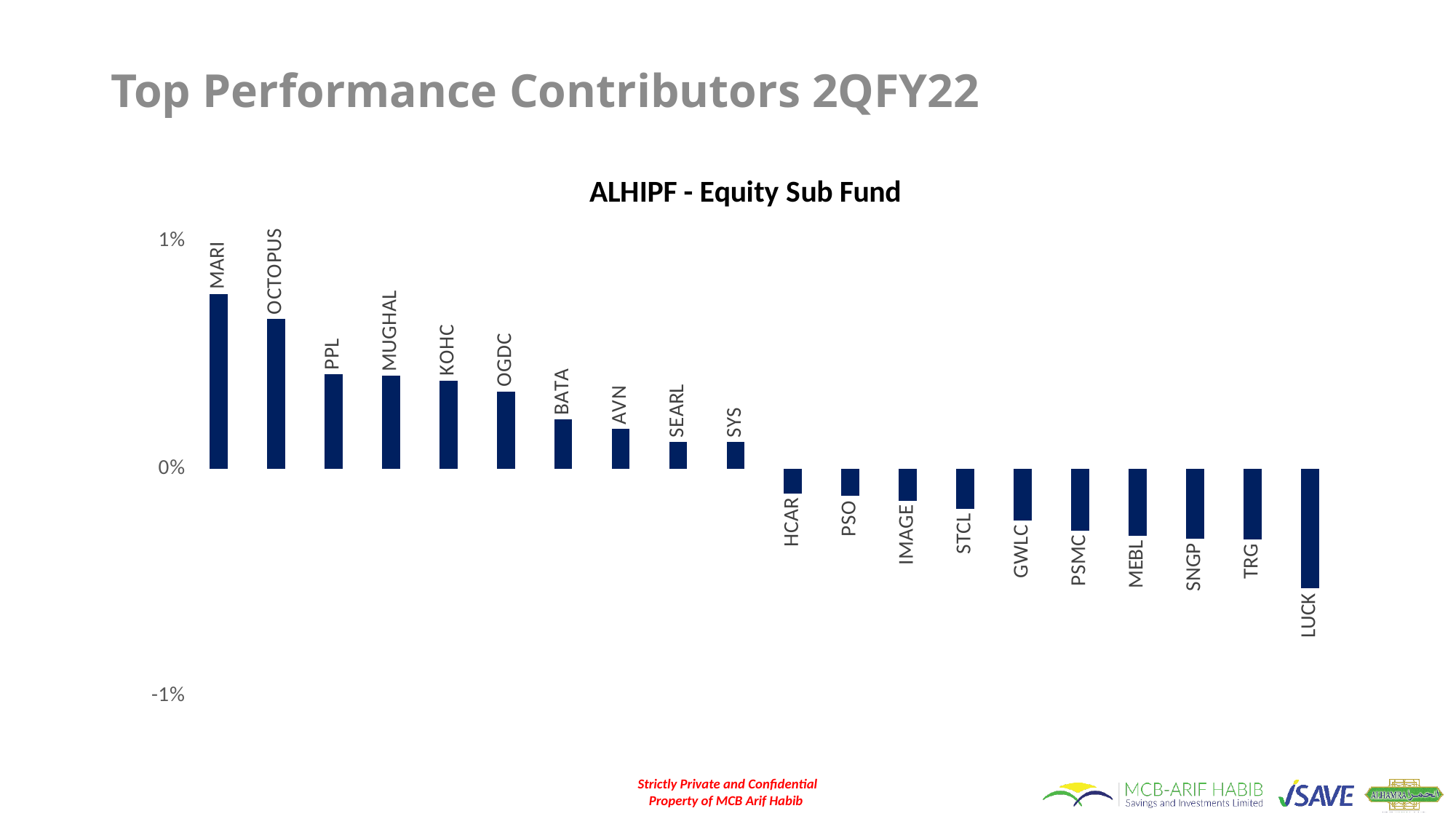
Which is larger, the value for MARI or the value for OCTOPUS? MARI Is the value for OCTOPUS greater or less than 1%? less Which category has the highest value in the chart? MARI What is the title of the chart? ALHIPF - Equity Sub Fund Which is larger, the value for SYS or the value for LUCK? SYS Which category has the lowest value in the chart? LUCK Is the value for HCAR greater or less than 0%? less What kind of chart is shown on the slide? bar chart How many categories (stocks) are plotted in the chart? 20 Is the value for LUCK greater or less than 0%? less Do the values generally rise or fall moving from left to right along the x axis? fall